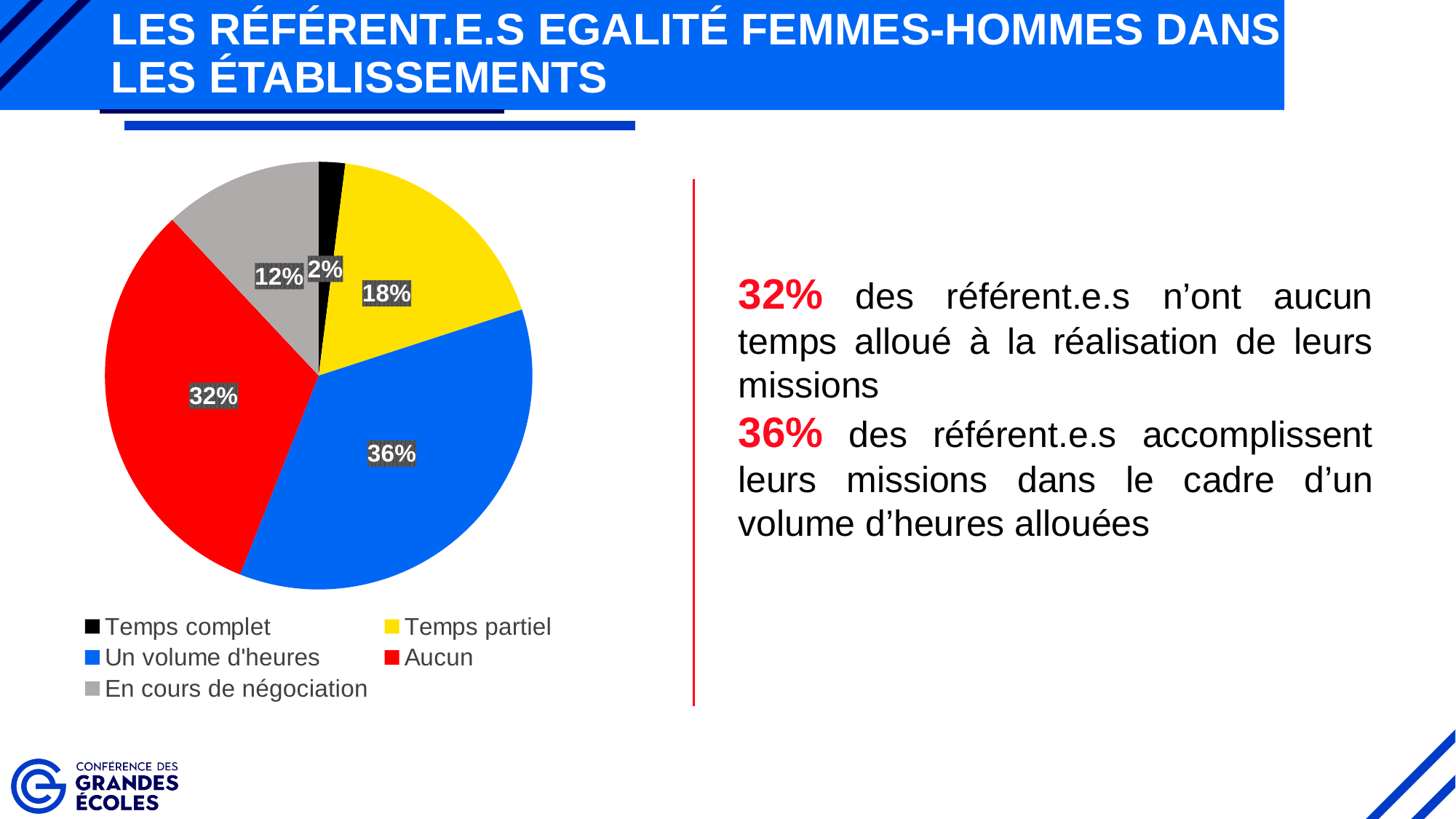
What share of the pie does "En cours de négociation" represent? 12% Which category has the smallest slice of the pie? Temps complet How many categories does the pie chart show? 5 What kind of chart is shown on the slide? pie chart What share of the pie does "Temps partiel" represent? 18% What share of the pie does "Un volume d'heures" represent? 36% Which category has the largest slice of the pie? Un volume d'heures What is the difference in percentage points between "Un volume d'heures" and "Aucun"? 4% What colour is the slice for "Aucun"? red Which is larger, the slice for "Temps partiel" or the slice for "En cours de négociation"? Temps partiel